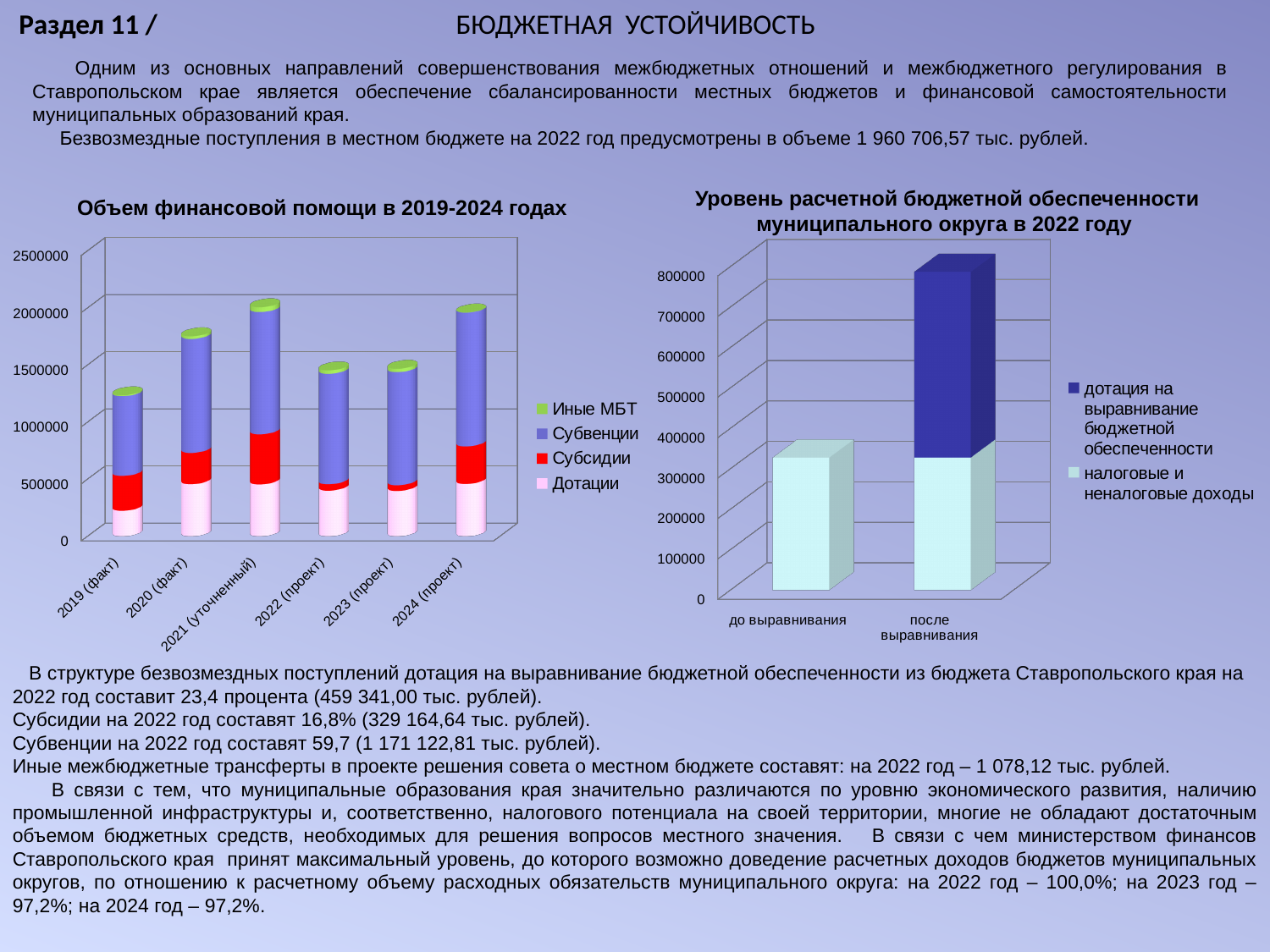
In the chart "Уровень расчетной бюджетной обеспеченности муниципального округа в 2022 году", is the total bar for "после выравнивания" greater or less than 700000? greater In the chart "Объем финансовой помощи в 2019-2024 годах", which year has the lowest total bar? 2019 (факт) In the chart "Объем финансовой помощи в 2019-2024 годах", which total bar is larger: 2020 (факт) or 2019 (факт)? 2020 (факт) What kind of chart is "Объем финансовой помощи в 2019-2024 годах"? Stacked bar chart How many series does the legend of the chart "Уровень расчетной бюджетной обеспеченности муниципального округа в 2022 году" list? 2 In the chart "Объем финансовой помощи в 2019-2024 годах", which series is shown in red? Субсидии In the chart "Объем финансовой помощи в 2019-2024 годах", is the total bar for 2019 (факт) greater or less than 1500000? less How many categories are shown on the x axis of the chart "Уровень расчетной бюджетной обеспеченности муниципального округа в 2022 году"? 2 In the chart "Уровень расчетной бюджетной обеспеченности муниципального округа в 2022 году", which bar is taller: "до выравнивания" or "после выравнивания"? после выравнивания How many categories (years) are shown on the x axis of the chart "Объем финансовой помощи в 2019-2024 годах"? 6 In the chart "Объем финансовой помощи в 2019-2024 годах", is the total bar for 2020 (факт) greater or less than 1500000? greater How many series does the legend of the chart "Объем финансовой помощи в 2019-2024 годах" list? 4